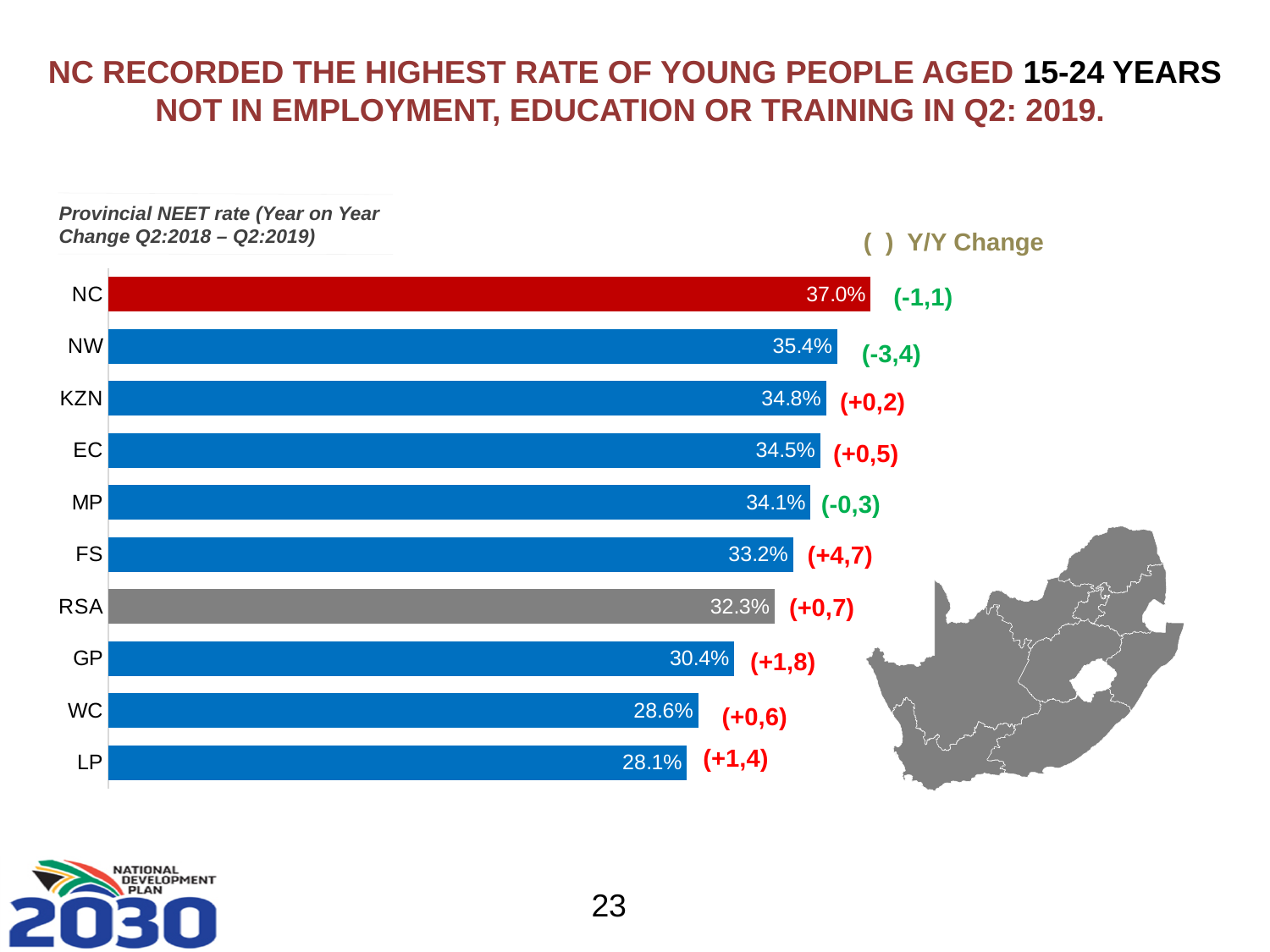
Which has a higher NEET rate, GP or WC? GP What is the title of the chart? Provincial NEET rate (Year on Year Change Q2:2018 – Q2:2019) Which province has the highest NEET rate? NC What is the year-on-year change shown for NW? (-3,4) What kind of chart is shown on the slide? Bar chart Which province has the lowest NEET rate? LP How many bars are shown in the chart? 10 What is the difference between the NEET rates of NC and NW? 1.6 percentage points What is the NEET rate for LP? 28.1% What is the NEET rate for RSA? 32.3% What is the NEET rate for NC? 37.0% What is the year-on-year change shown for FS? (+4,7)